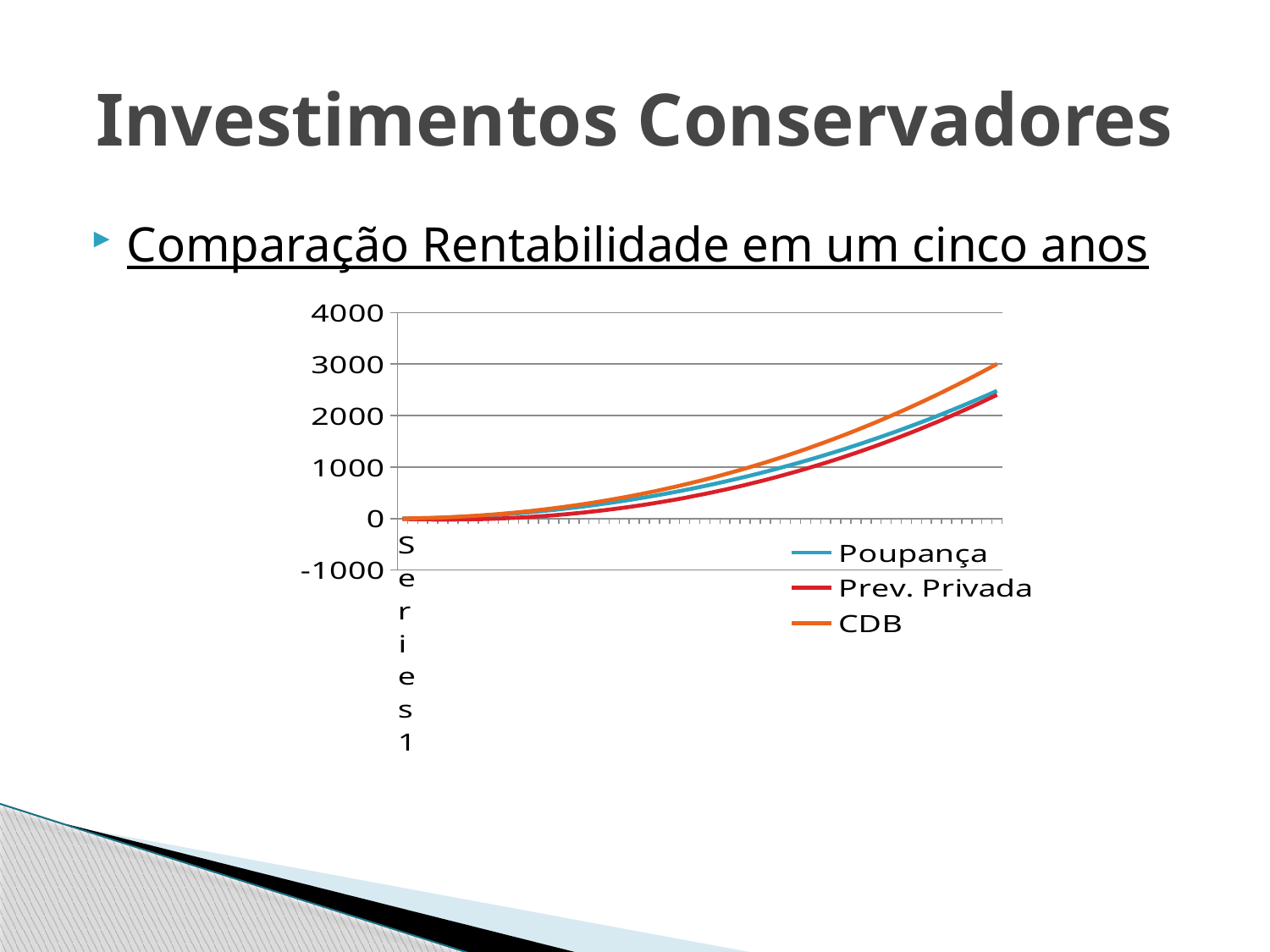
What is the highest value shown on the chart's vertical axis? 4000 Is the final value of the CDB series greater or less than 2000? greater Do the values of the CDB series rise or fall along the x axis? rise Which series are listed in the chart legend? Poupança, Prev. Privada, CDB Is the final value of the Poupança series greater or less than 1000? greater What colour is the CDB line in the chart? orange Which series reaches the highest value at the right end of the chart? CDB How many series does the chart legend list? 3 What kind of chart is shown on the slide? line chart Is the final value of the Prev. Privada series greater or less than 3000? less At the right end of the chart, which is larger: the CDB value or the Prev. Privada value? CDB Do the values of the Poupança series rise or fall along the x axis? rise